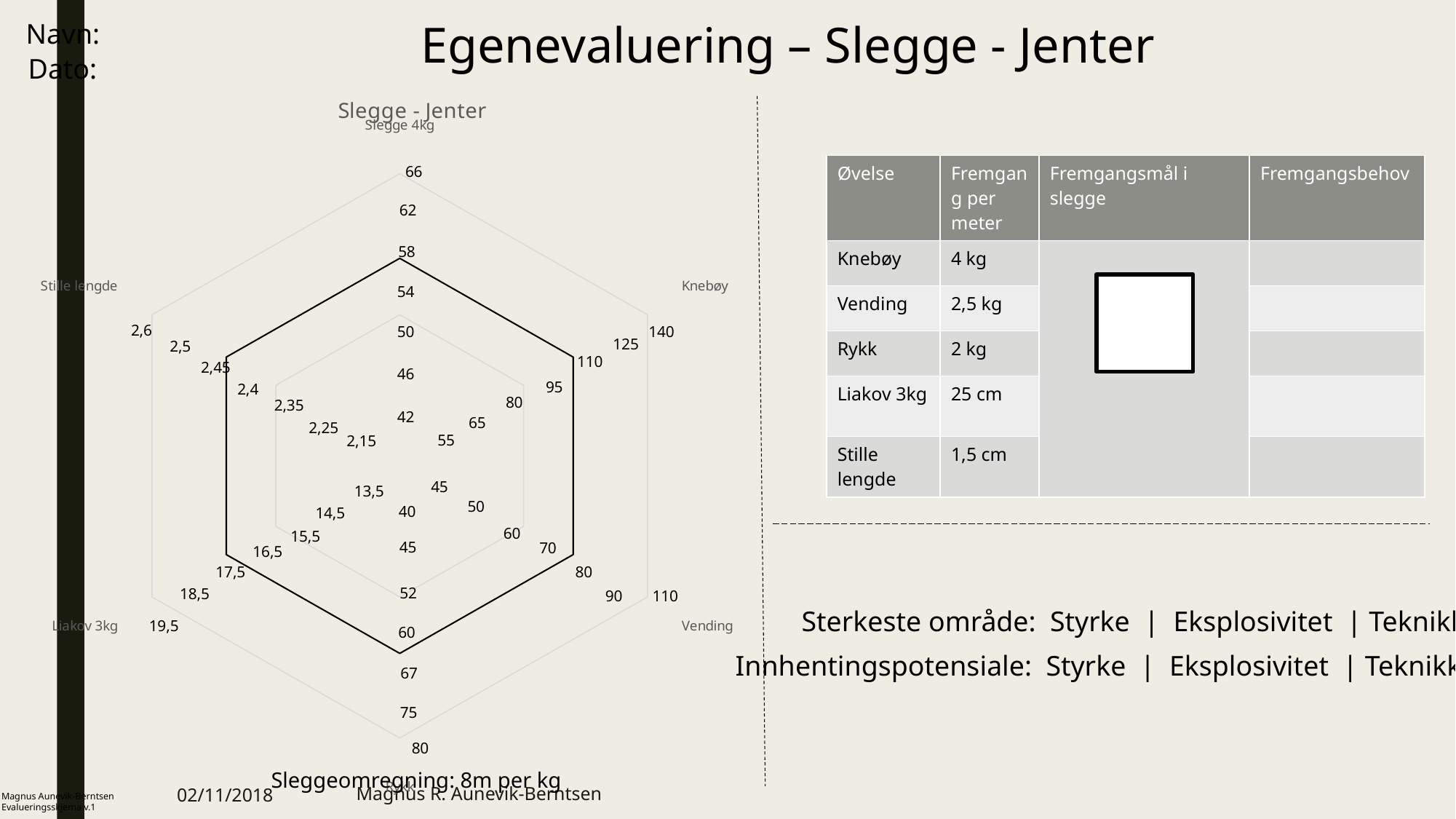
Is the plotted value on the Slegge 4kg axis greater or less than 66? less What kind of chart is shown on the slide? radar chart Is the plotted value on the Liakov 3kg axis greater or less than 13,5? greater Is the plotted value on the Stille lengde axis greater or less than 2,15? greater What value does the plotted line reach on the Slegge 4kg axis? 58 Which category is plotted on the top axis of the radar chart? Slegge 4kg What is the title of the radar chart? Slegge - Jenter How many axes (categories) does the radar chart have? 6 What value does the plotted line reach on the Knebøy axis? 110 What value does the plotted line reach on the Rykk axis? 60